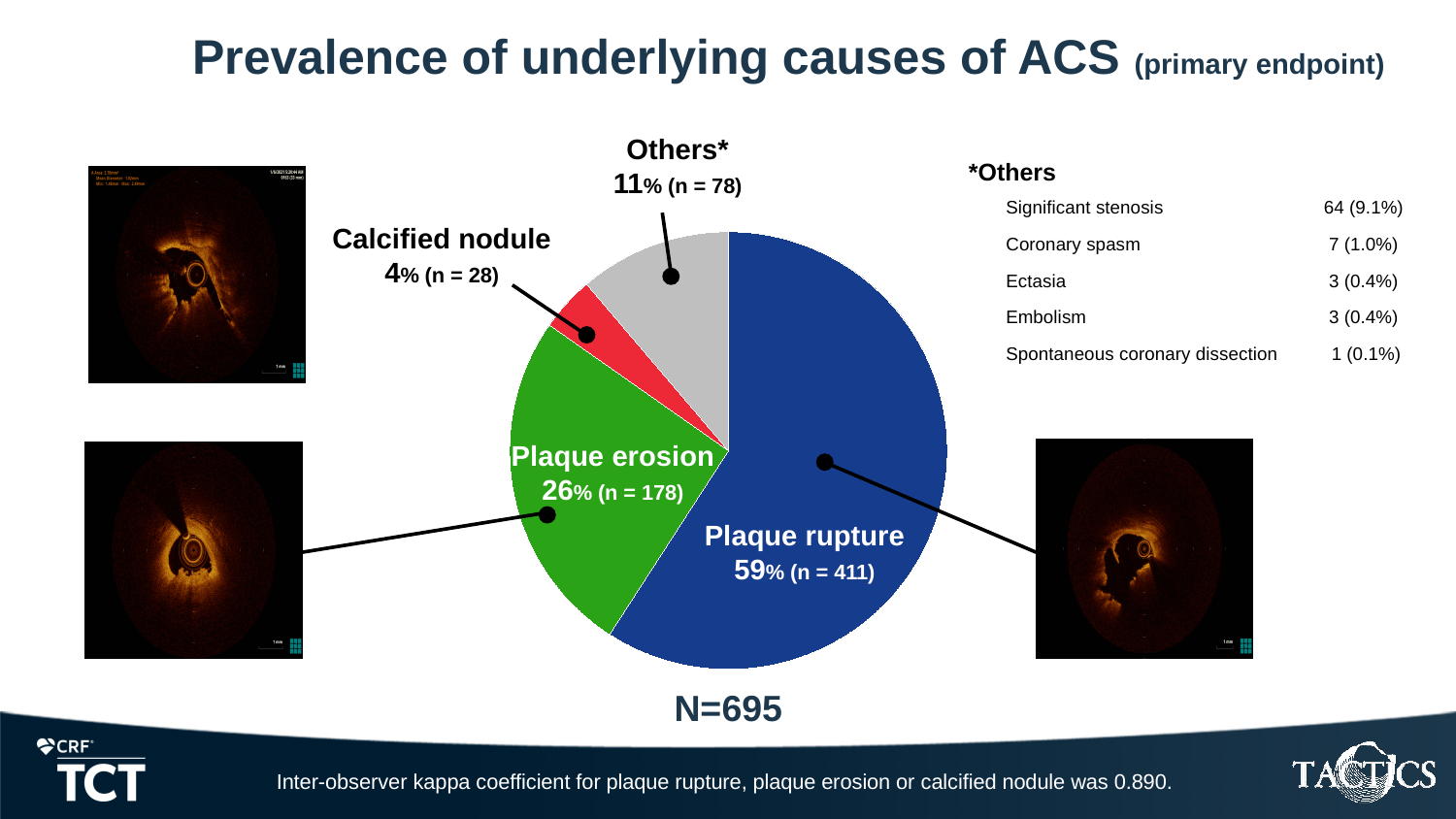
How many cases (n) are in the Others* slice? 78 How many slices does the pie chart have? 4 How many cases (n) are in the Plaque erosion slice? 178 Which is larger, the Others* slice or the Calcified nodule slice? Others* What colour is the Plaque erosion slice? green What type of chart is shown on the slide? pie chart What percentage is shown for Calcified nodule? 4% Which category has the largest slice of the pie? Plaque rupture What percentage of the pie does Plaque rupture account for? 59% What is the total N shown below the pie chart? N=695 Which category has the smallest slice of the pie? Calcified nodule What is the difference in percentage points between Plaque rupture and Plaque erosion? 33